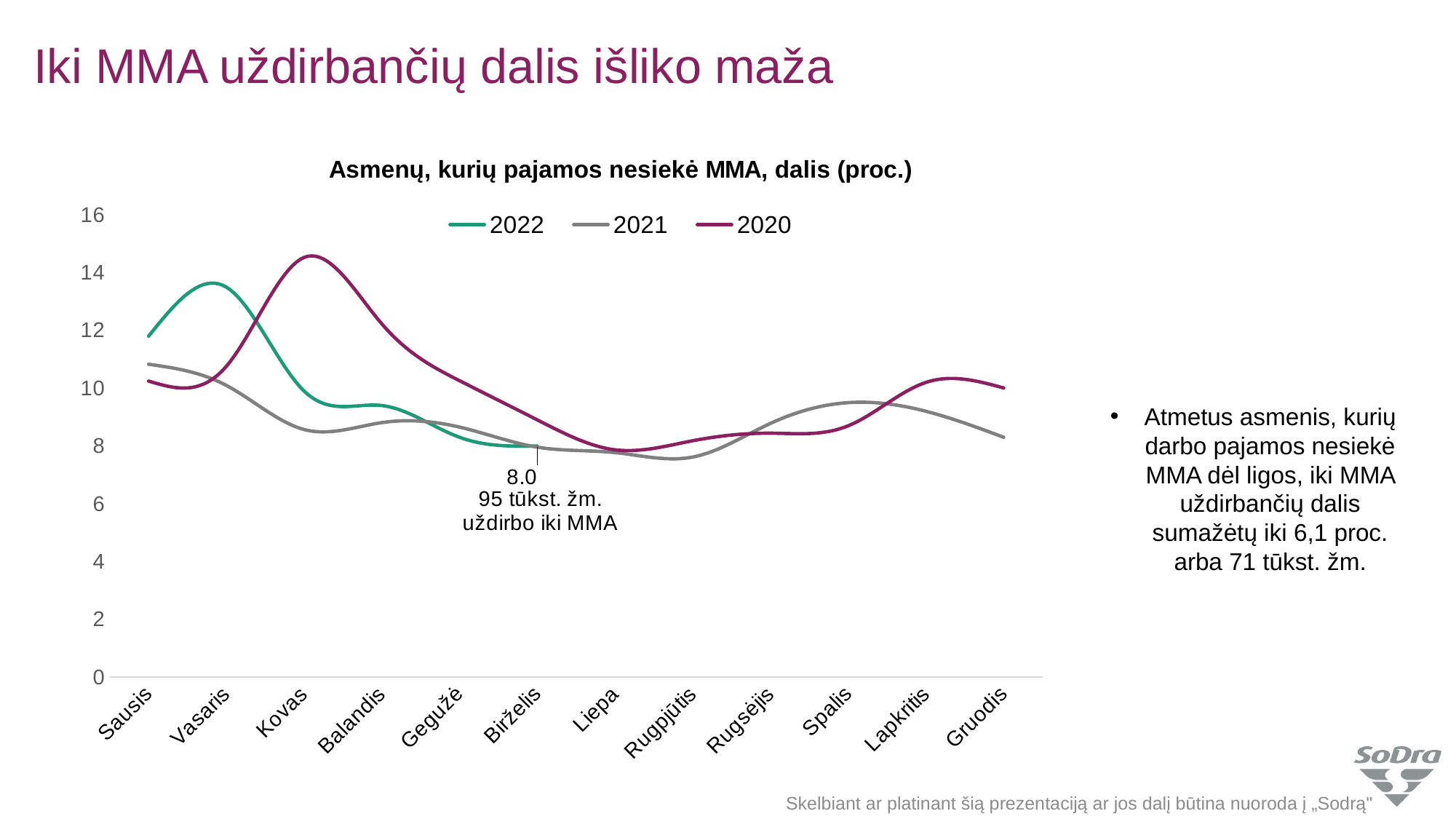
What is the title of the chart? Asmenų, kurių pajamos nesiekė MMA, dalis (proc.) In Kovas, which series has the larger value, 2020 or 2022? 2020 Does the 2022 line rise or fall from Vasaris to Birželis? fall Is the value for 2020 in Gruodis greater or less than 8? greater Is the value for 2021 in Sausis greater or less than 10? greater In which month does the 2022 line reach its highest value? Vasaris In which month does the 2020 line reach its highest value? Kovas How many series does the legend list? 3 What is the value for 2022 in Birželis? 8.0 How many months are shown on the x axis? 12 Is the value for 2020 in Kovas greater or less than 14? greater What kind of chart is shown on the slide? line chart